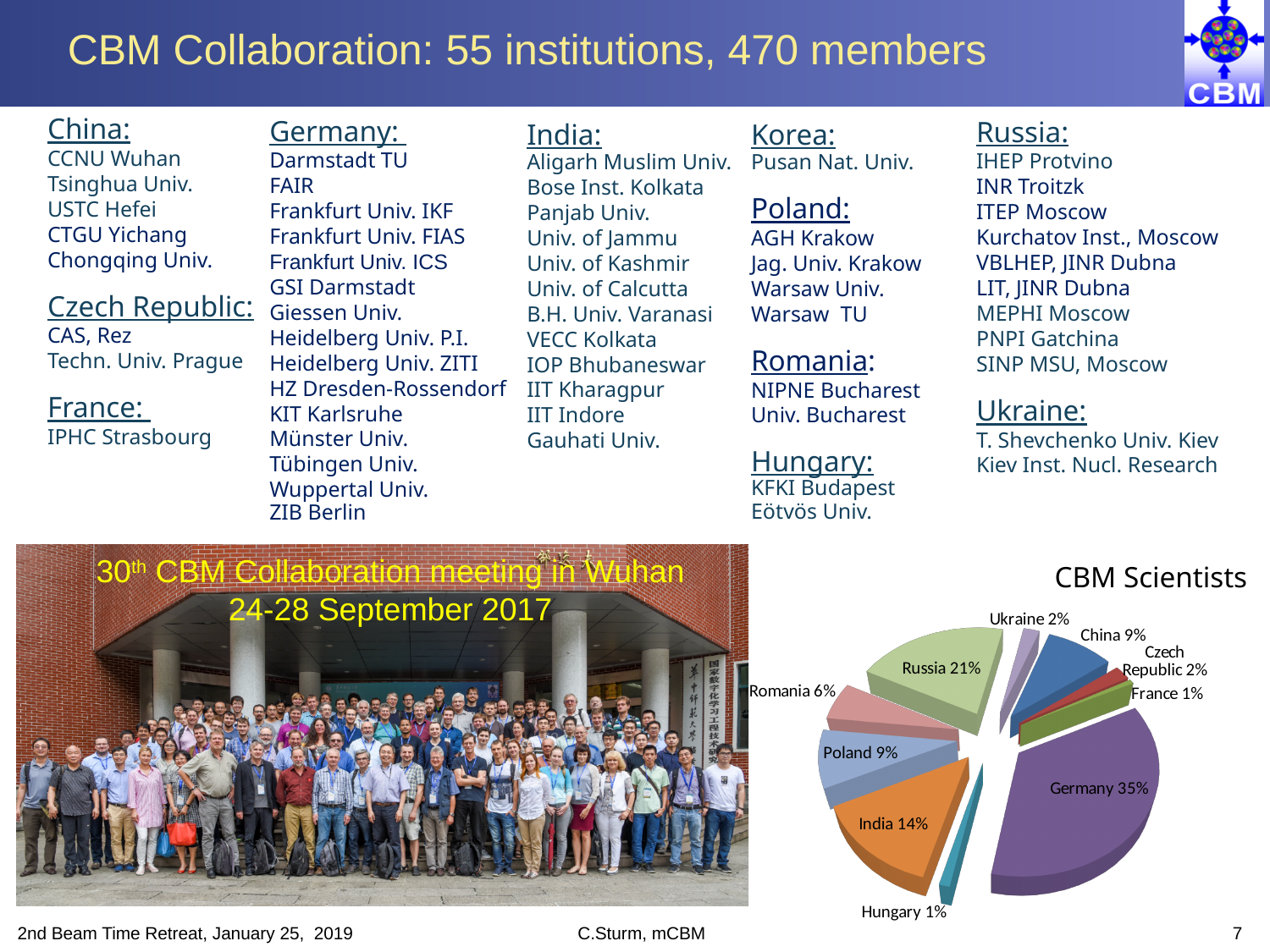
In the CBM Scientists pie chart, what is the difference between India's share and Poland's share? 5% In the CBM Scientists pie chart, which country has a larger share, Russia or India? Russia In the CBM Scientists pie chart, what is the difference between Germany's share and Russia's share? 14% In the CBM Scientists pie chart, what share does Russia have? 21% In the CBM Scientists pie chart, which country has the largest share? Germany In the CBM Scientists pie chart, what share does Germany have? 35% In the CBM Scientists pie chart, what share does Ukraine have? 2% What kind of chart is shown under the title "CBM Scientists"? pie chart What is the title of the pie chart on the slide? CBM Scientists How many slices does the CBM Scientists pie chart have? 10